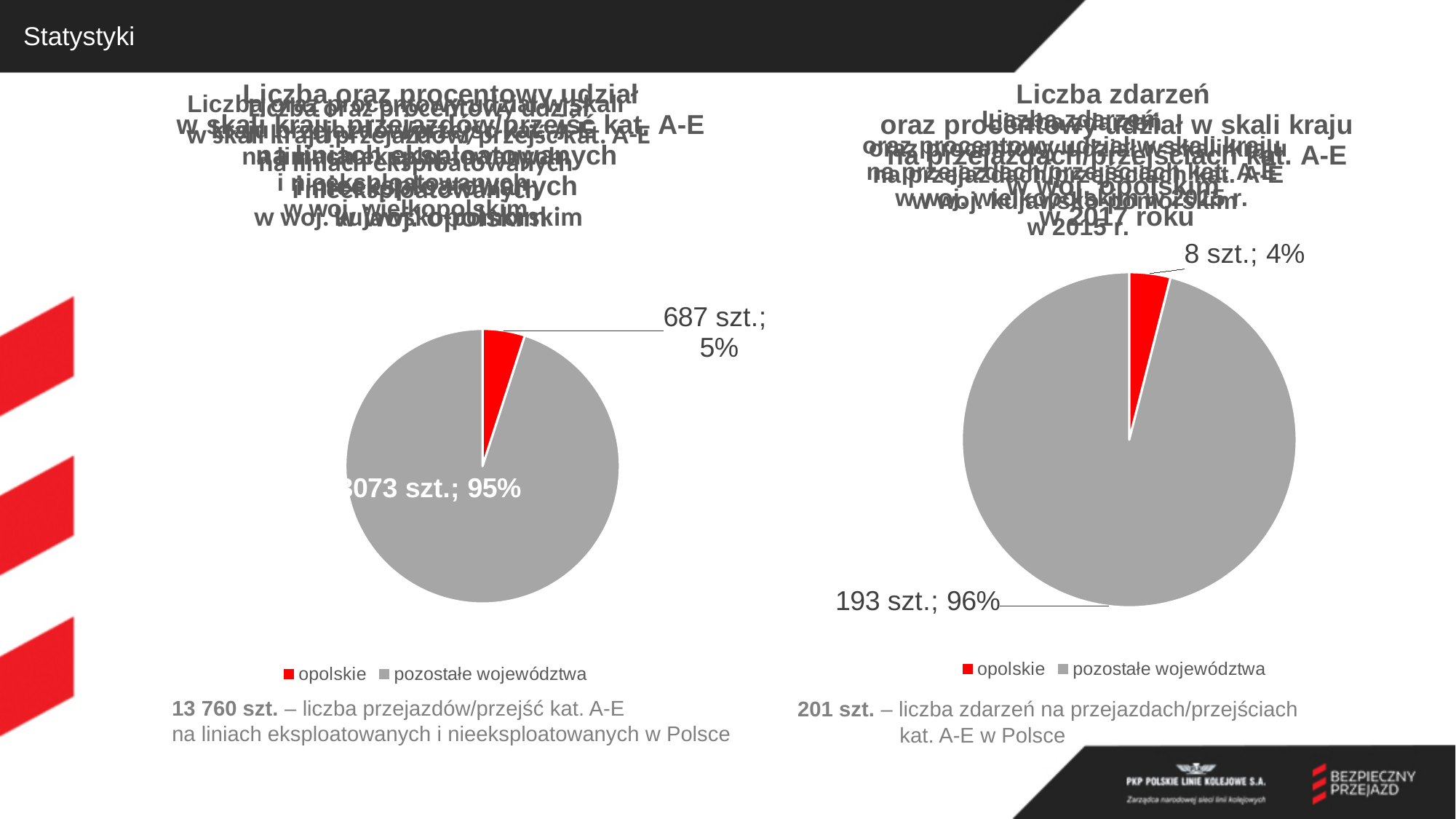
How many entries does the legend of the left pie chart list? 2 What kind of chart is the left chart on the slide? pie chart In the right pie chart, which category has the smallest slice? opolskie In the right pie chart, what colour is the slice for opolskie? red In the right pie chart, what value is shown for opolskie? 8 szt. In the left pie chart, what share of the pie does opolskie have? 5% In the right pie chart, what share of the pie does opolskie have? 4% In the left pie chart, which slice is larger, opolskie or pozostałe województwa? pozostałe województwa In the right pie chart, what value is shown for pozostałe województwa? 193 szt. In the right pie chart, what is the difference between the values for pozostałe województwa and opolskie? 185 szt. In the left pie chart, what value is shown for opolskie? 687 szt. In the left pie chart, what share of the pie does pozostałe województwa have? 95%